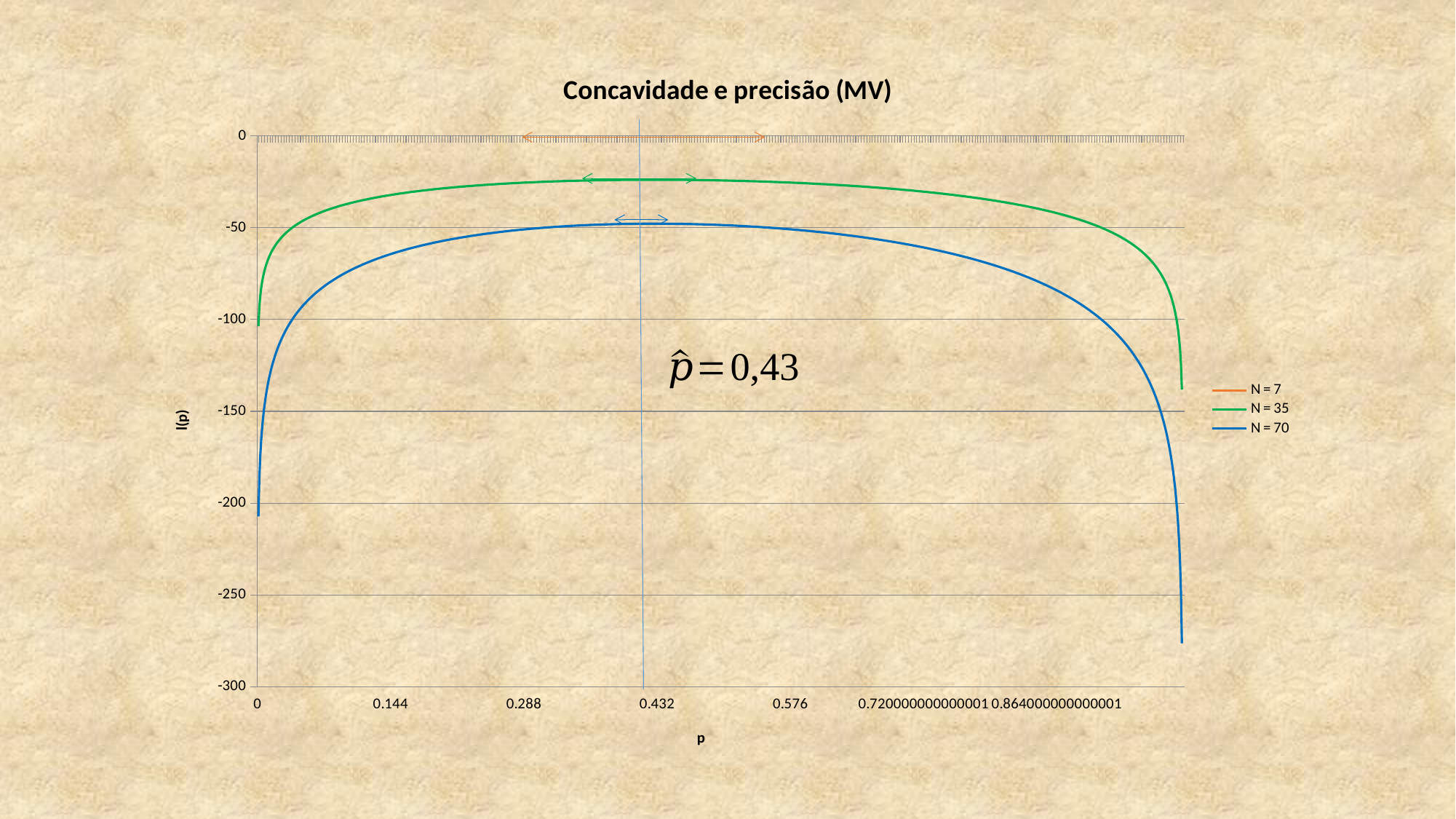
How many series does the legend list? 3 Which series does the legend associate with the blue line? N = 70 What is the title of the chart? Concavidade e precisão (MV) Is the maximum value of the N = 35 curve greater or less than -50? greater At p = 0.432, which series has the higher value of l(p): N = 35 or N = 70? N = 35 What kind of chart is shown on the slide? line chart Does the N = 70 curve rise or fall as p increases from 0.432 to the right end of the axis? fall Is the value of the N = 35 curve at its right-hand end greater or less than -100? less What value of p-hat is printed on the chart? 0,43 Is the value of the N = 70 curve at p = 0 greater or less than -200? less Does the N = 35 curve rise or fall as p increases from 0 to 0.432? rise